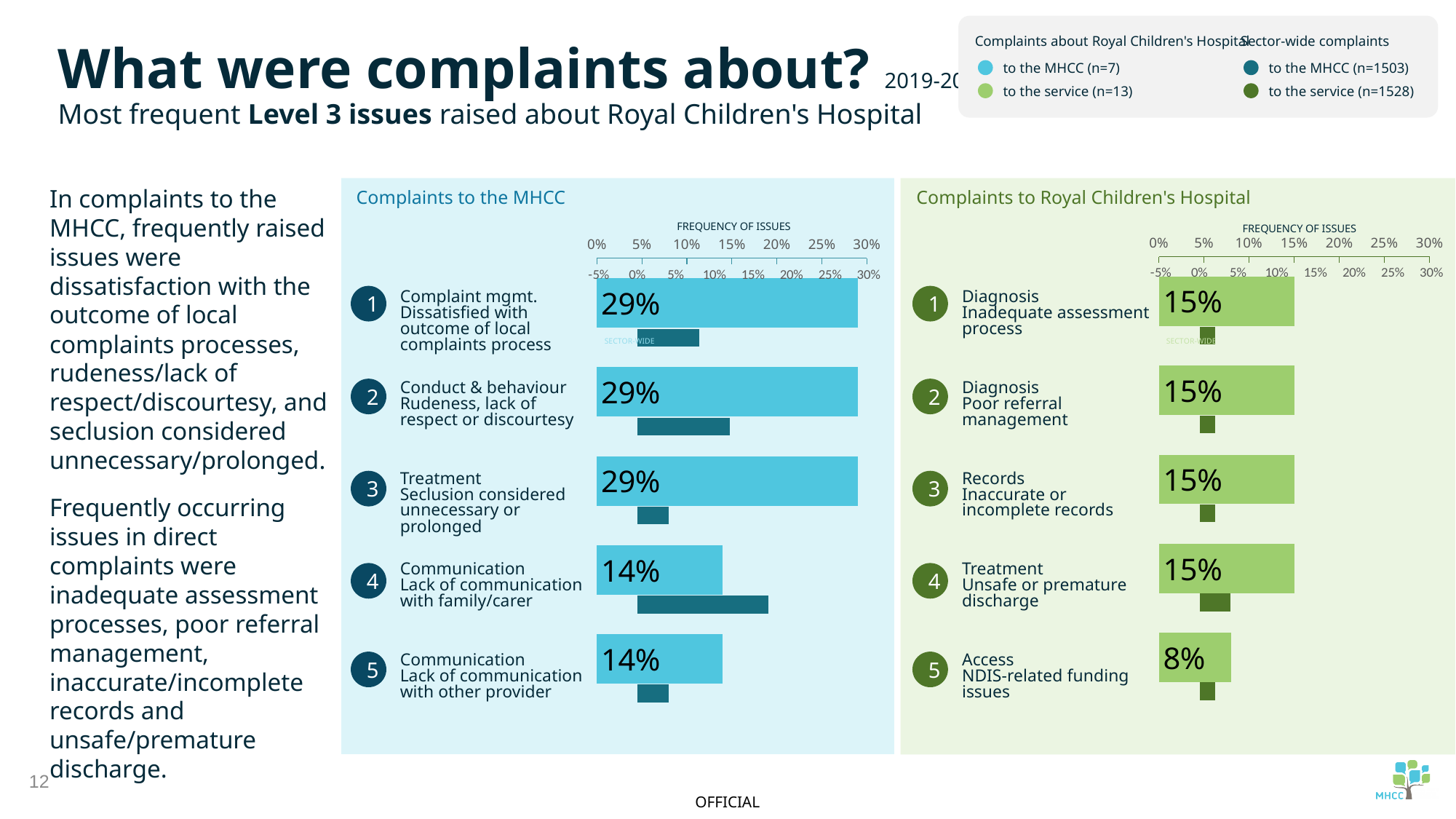
In the 'Complaints to Royal Children's Hospital' chart, what is the difference in frequency between 'Diagnosis: Inadequate assessment process' and 'Access: NDIS-related funding issues'? 7 percentage points In the 'Complaints to Royal Children's Hospital' chart, what is the frequency of issues for 'Access: NDIS-related funding issues'? 8% In the 'Complaints to Royal Children's Hospital' chart, what is the frequency of issues for 'Diagnosis: Inadequate assessment process'? 15% How many series does the legend at the top right of the slide list? 4 In the 'Complaints to the MHCC' chart, what is the difference in frequency between 'Complaint mgmt. Dissatisfied with outcome of local complaints process' and 'Communication: Lack of communication with other provider'? 15 percentage points In the 'Complaints to Royal Children's Hospital' chart, which issue has the lowest frequency? Access: NDIS-related funding issues How many issues are listed in the 'Complaints to the MHCC' chart? 5 In the 'Complaints to the MHCC' chart, what is the frequency of issues for 'Communication: Lack of communication with family/carer'? 14% In the 'Complaints to the MHCC' chart, which has the higher frequency: 'Treatment: Seclusion considered unnecessary or prolonged' or 'Communication: Lack of communication with family/carer'? Treatment: Seclusion considered unnecessary or prolonged In the 'Complaints to the MHCC' chart, is the sector-wide value for 'Complaint mgmt. Dissatisfied with outcome of local complaints process' greater or less than 10%? less What type of chart is used in the 'Complaints to Royal Children's Hospital' panel? Bar chart In the 'Complaints to the MHCC' chart, what is the frequency of issues for 'Complaint mgmt. Dissatisfied with outcome of local complaints process'? 29%